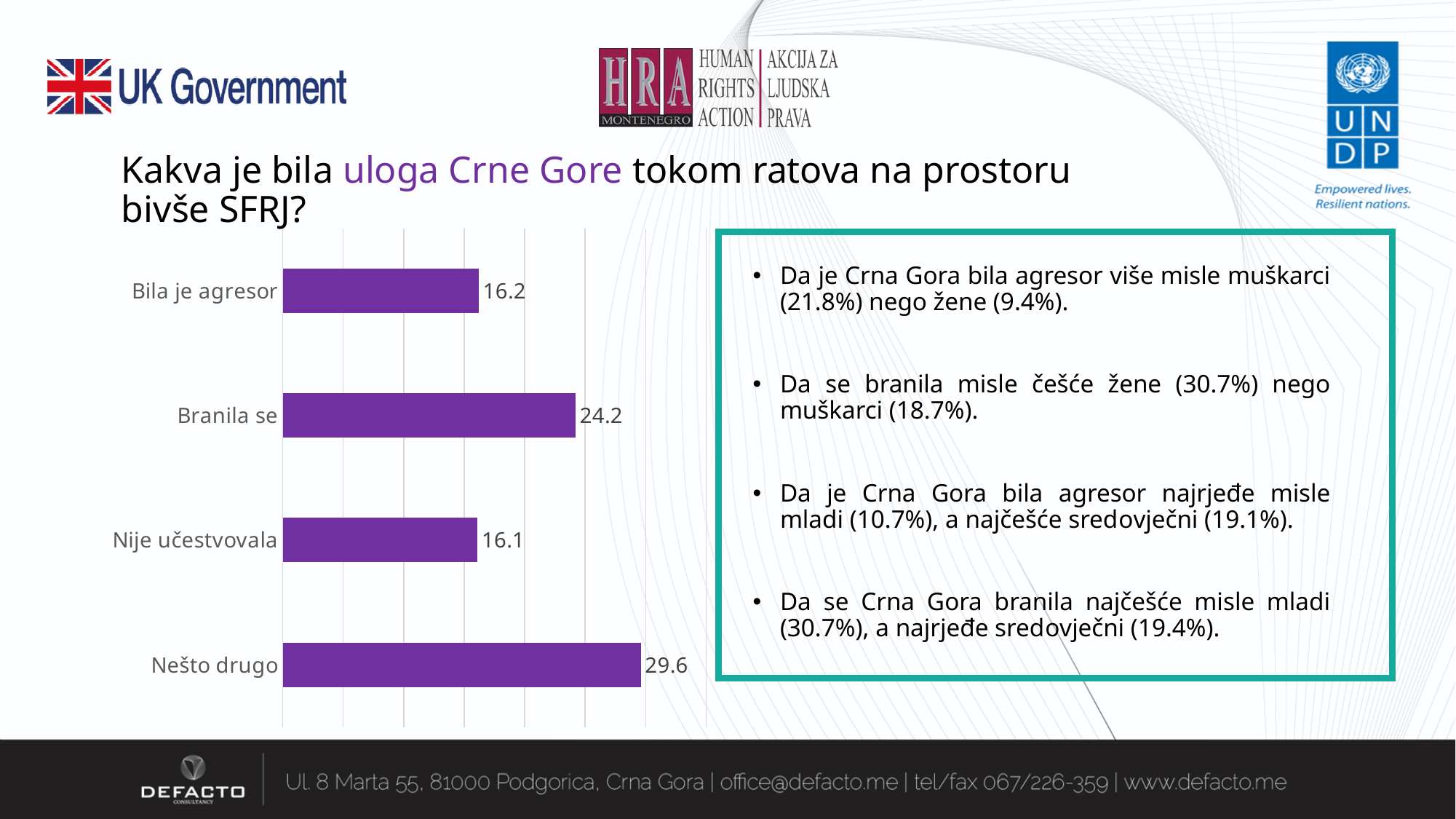
What is the difference between the values for "Branila se" and "Bila je agresor"? 8 What is the value for "Nije učestvovala"? 16.1 How many categories are shown in the chart? 4 What is the value for "Nešto drugo"? 29.6 What is the value for "Branila se"? 24.2 What colour are the bars in the chart? Purple What kind of chart is shown on the slide? Bar chart Which category has the highest value? Nešto drugo Which category has the lowest value? Nije učestvovala Which is larger, the value for "Branila se" or the value for "Nije učestvovala"? Branila se What is the difference between the values for "Nešto drugo" and "Branila se"? 5.4 What is the value for "Bila je agresor"? 16.2